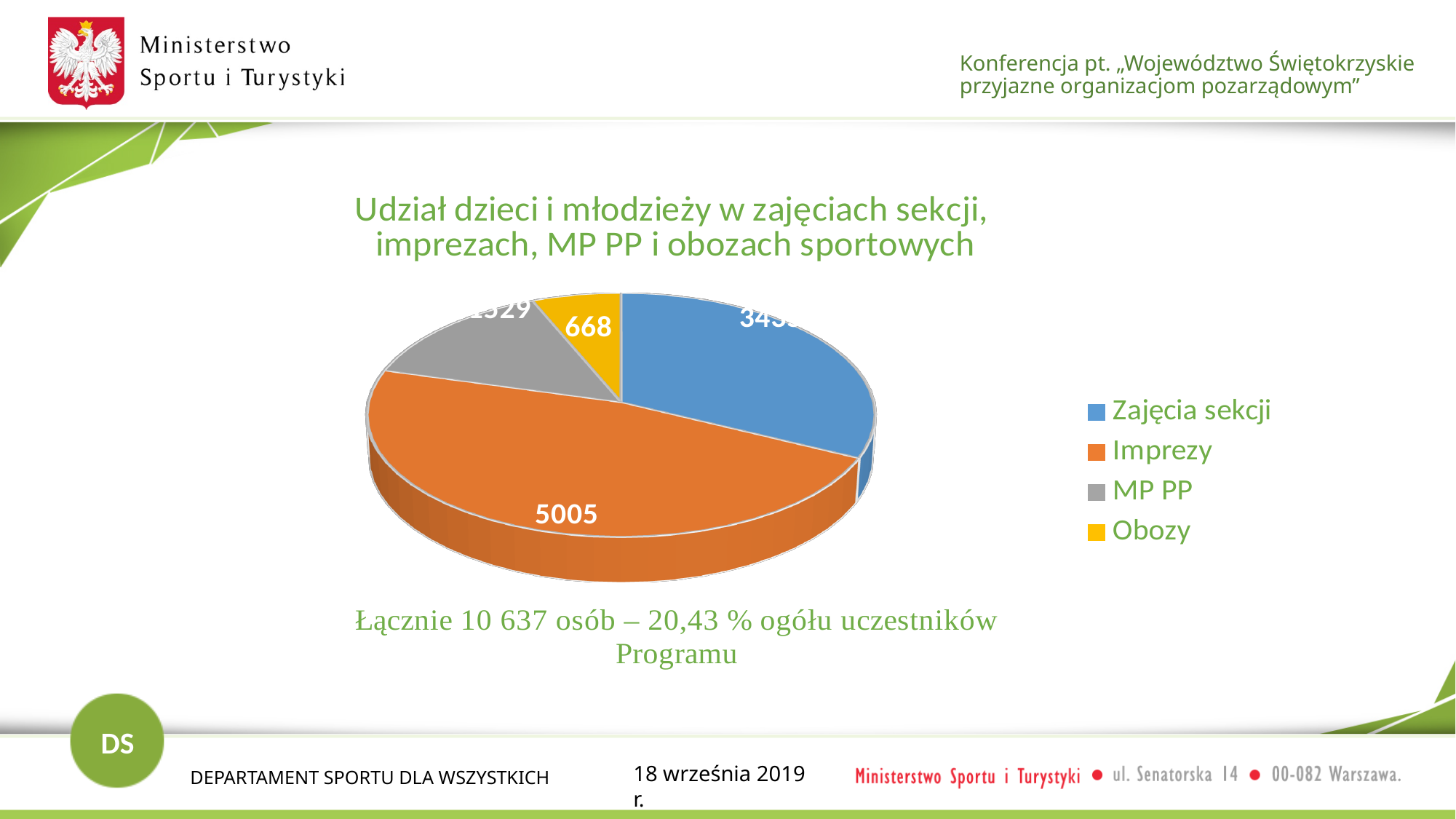
How many categories does the legend of the pie chart list? 4 Which category has the smallest slice of the pie? Obozy What is the value for Imprezy? 5005 What kind of chart is shown on the slide? pie chart Which is larger, Imprezy or Zajęcia sekcji? Imprezy Which is larger, MP PP or Obozy? MP PP How many slices does the pie chart have? 4 What is the value for Obozy? 668 Which colour represents MP PP in the pie chart? grey Which category has the largest slice of the pie? Imprezy What is the difference between the values for Imprezy and Obozy? 4337 What is the title of the chart? Udział dzieci i młodzieży w zajęciach sekcji, imprezach, MP PP i obozach sportowych